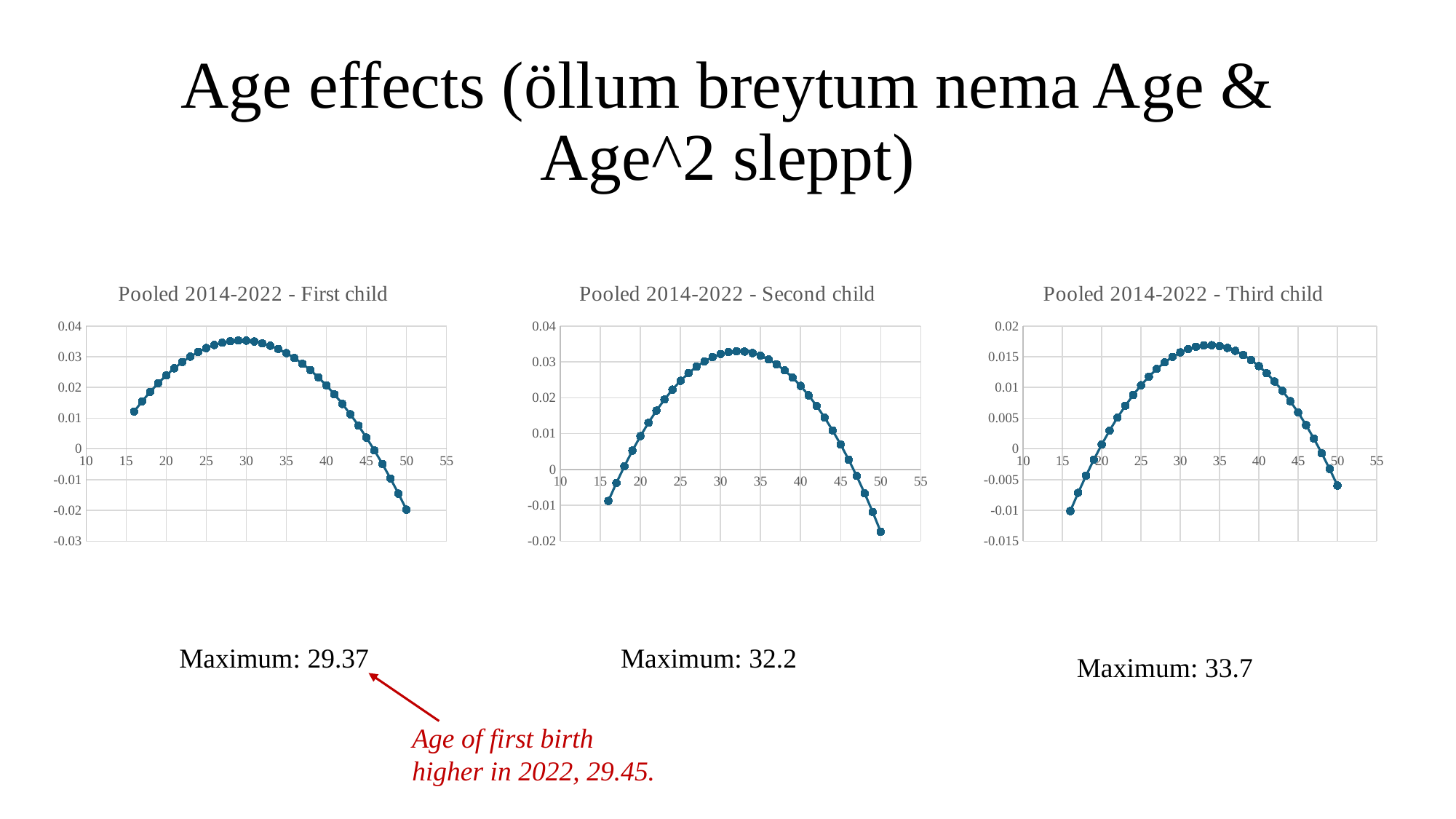
How many charts are shown on the slide? 3 What kind of chart is 'Pooled 2014-2022 - First child'? line chart What maximum age is stated below the 'Pooled 2014-2022 - Second child' chart? 32.2 Which of the three charts has the lowest peak value? Pooled 2014-2022 - Third child In the 'Pooled 2014-2022 - Third child' chart, is the peak value greater or less than 0.015? greater In the 'Pooled 2014-2022 - Second child' chart, is the value at age 16 greater or less than 0? less In the 'Pooled 2014-2022 - First child' chart, is the value at age 16 greater or less than 0.01? greater In the 'Pooled 2014-2022 - First child' chart, do the values rise or fall between age 16 and age 25? rise In the 'Pooled 2014-2022 - Second child' chart, do the values rise or fall between age 40 and age 50? fall